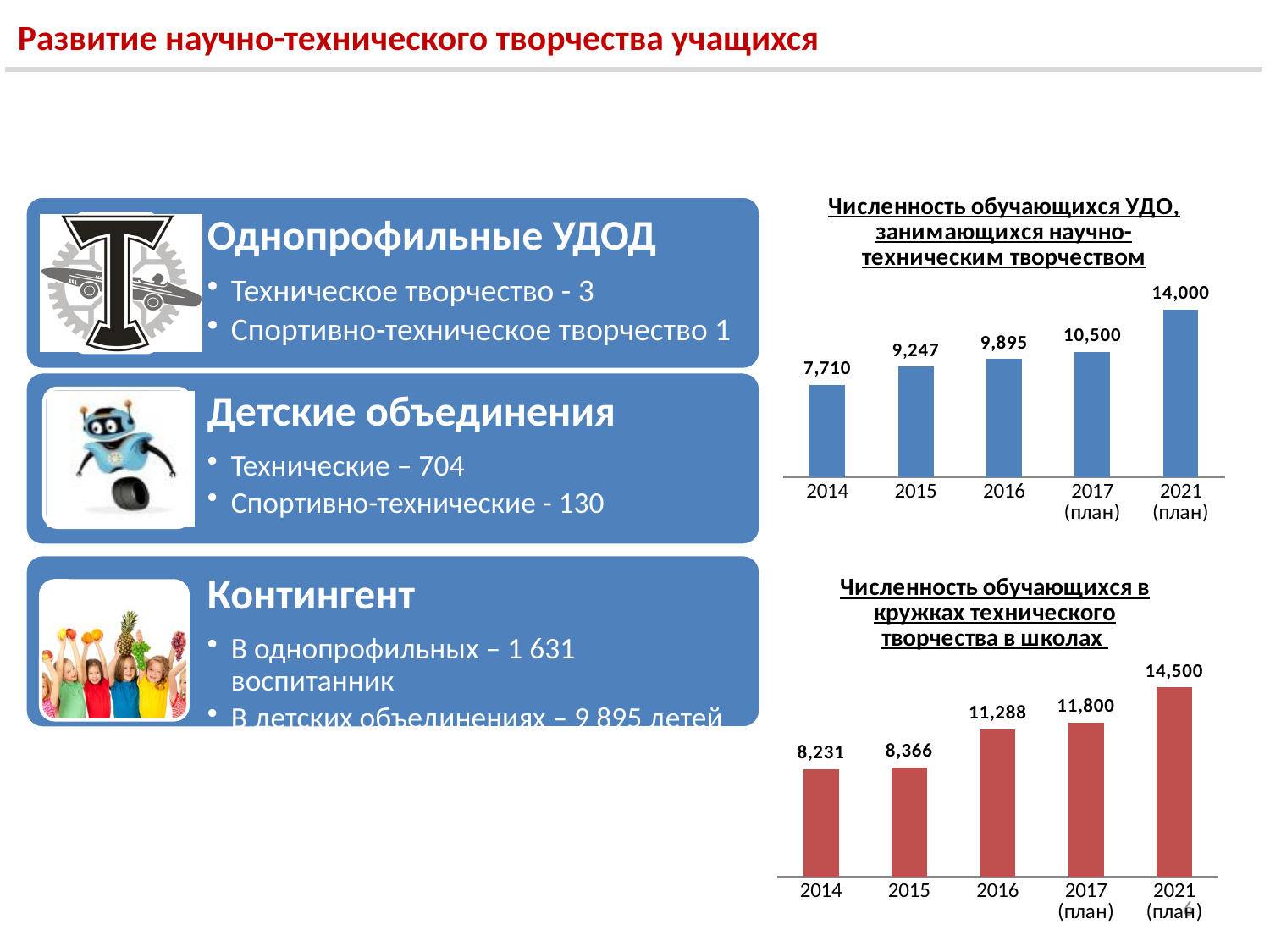
In the bottom chart (Численность обучающихся в кружках технического творчества в школах), what is the value for 2021 (план)? 14,500 In the top chart (Численность обучающихся УДО), what is the value for 2014? 7,710 How many bars does the bottom chart (Численность обучающихся в кружках технического творчества в школах) have? 5 Which is larger: the 2017 (план) value in the top chart or the 2017 (план) value in the bottom chart? the bottom chart (11,800) In the bottom chart (Численность обучающихся в кружках технического творчества в школах), what is the value for 2015? 8,366 What type of chart is the top chart (Численность обучающихся УДО)? bar chart In the top chart (Численность обучающихся УДО), what is the difference between the 2021 (план) value and the 2017 (план) value? 3,500 In the top chart (Численность обучающихся УДО), which year has the highest value? 2021 (план) In the top chart (Численность обучающихся УДО), what is the value for 2016? 9,895 In the bottom chart (Численность обучающихся в кружках технического творчества в школах), what is the difference between the 2016 value and the 2015 value? 2,922 In the top chart (Численность обучающихся УДО), do the values rise or fall from 2014 to 2021 (план)? rise In the bottom chart (Численность обучающихся в кружках технического творчества в школах), which year has the lowest value? 2014